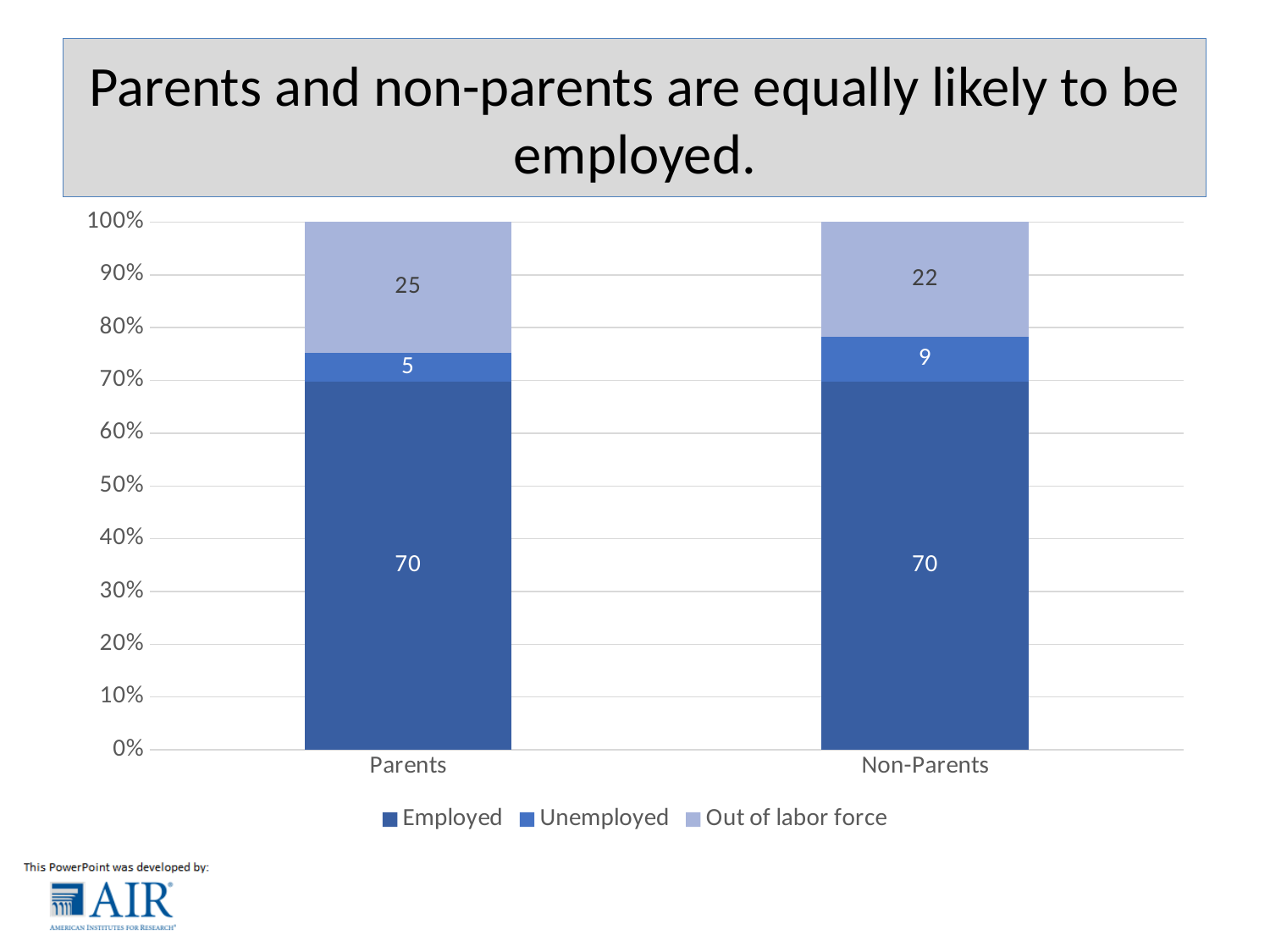
What is the Out of labor force value for Non-Parents? 22 How many series does the legend list? 3 Which category has the higher Out of labor force value? Parents What is the Unemployed value for Non-Parents? 9 What is the Employed value for Parents? 70 What is the difference between the Unemployed values for Non-Parents and Parents? 4 What is the total of the stacked bar for Parents? 100 What is the Out of labor force value for Parents? 25 How many categories are shown on the x axis? 2 What kind of chart is shown on the slide? Stacked bar chart What is the difference between the Out of labor force values for Parents and Non-Parents? 3 Which category has the higher Unemployed value, Parents or Non-Parents? Non-Parents